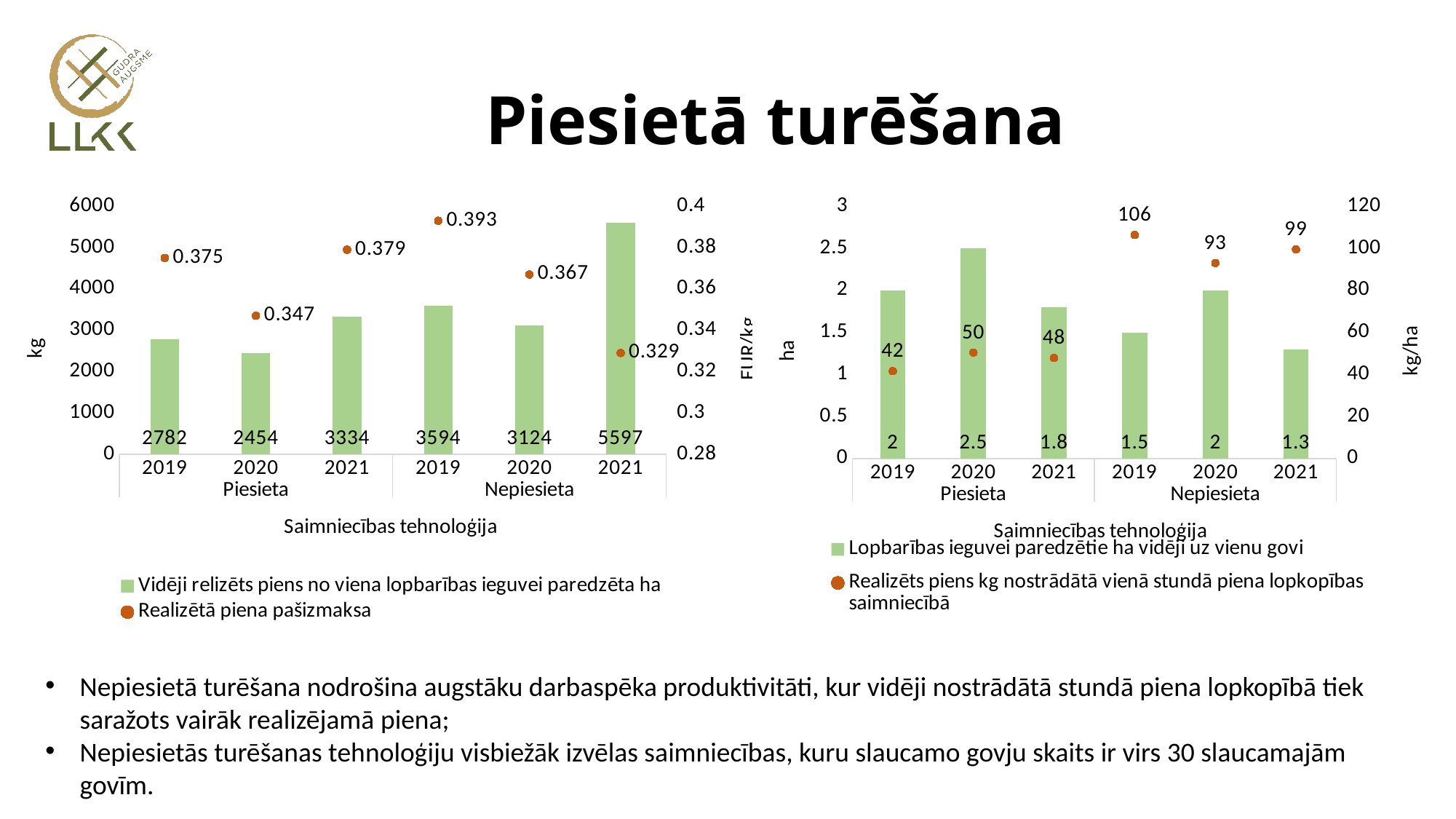
In the left chart, what is the Realizētā piena pašizmaksa value for Piesieta 2020? 0.347 In the left chart, what is the difference between the bar values for Piesieta 2021 and Piesieta 2020? 880 In the left chart, which category has the highest bar value? Nepiesieta 2021 In the right chart, how many categories are shown on the x axis? 6 In the right chart, which category has the lowest bar value? Nepiesieta 2021 What type of chart is the left chart? Combined bar and line (marker) chart In the left chart, which category has the lowest Realizētā piena pašizmaksa value? Nepiesieta 2021 In the right chart, which is larger, the kg/ha value for Nepiesieta 2020 or Nepiesieta 2021? Nepiesieta 2021 In the left chart, how many series does the legend list? 2 In the right chart, what is the Lopbarības ieguvei paredzētie ha value for Piesieta 2020? 2.5 In the right chart, what is the Realizēts piens kg nostrādātā vienā stundā value for Nepiesieta 2019? 106 In the left chart, what is the value of the bar for Nepiesieta 2021? 5597